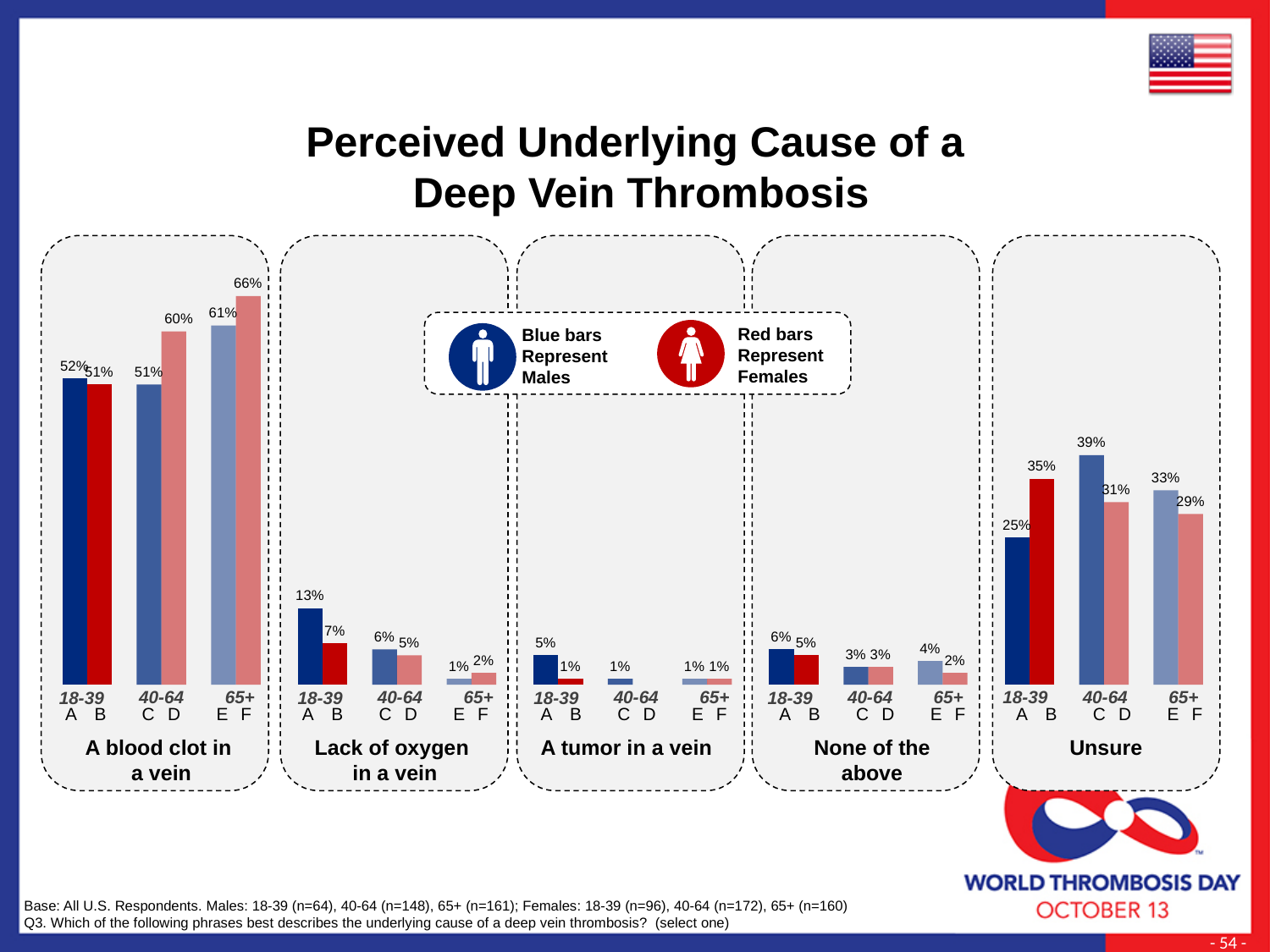
According to the legend, what do the red bars represent? Females What percentage of males aged 18-39 answered 'Lack of oxygen in a vein'? 13% What percentage of females aged 18-39 answered 'A tumor in a vein'? 1% What is the difference between females aged 18-39 and males aged 18-39 in the 'Unsure' category? 10% For 'Lack of oxygen in a vein' among 18-39 year olds, which is larger, the male value or the female value? Male How many response categories (panels) are shown in the chart? 5 Within the 'Unsure' category, which age and gender group has the lowest value? Males 18-39 What is the difference between females and males aged 40-64 for 'A blood clot in a vein'? 9% What percentage of females aged 65+ perceived a blood clot in a vein as the underlying cause of a deep vein thrombosis? 66% Which response category has the highest value for males aged 65+? A blood clot in a vein What type of chart is shown on the slide? Bar chart What percentage of males aged 40-64 answered 'Unsure'? 39%